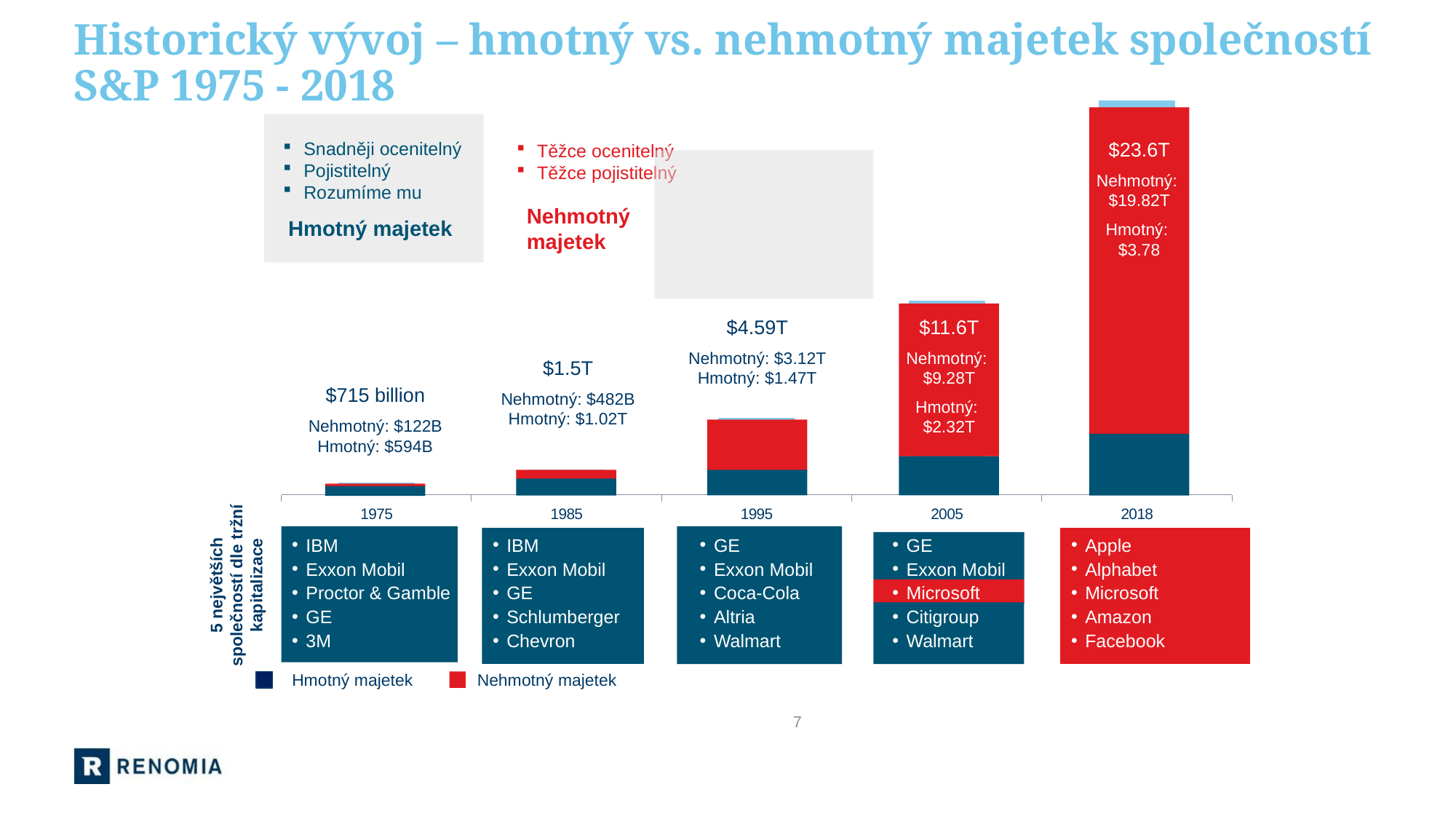
What is the value of Hmotný majetek for 2005? $2.32T What is the value of Nehmotný majetek for 1995? $3.12T Do the total bar values rise or fall from 1975 to 2018? Rise What is the difference between Nehmotný majetek and Hmotný majetek in 2005? $6.96T How many series does the legend list? 2 In 1985, which is larger: Hmotný majetek or Nehmotný majetek? Hmotný majetek What is the total value shown for 1975? $715 billion How many years are shown on the x axis of the chart? 5 What kind of chart is shown on the slide? Stacked bar chart Which year has the highest total bar? 2018 Which year has the lowest total bar? 1975 What is the total value shown above the bar for 2018? $23.6T